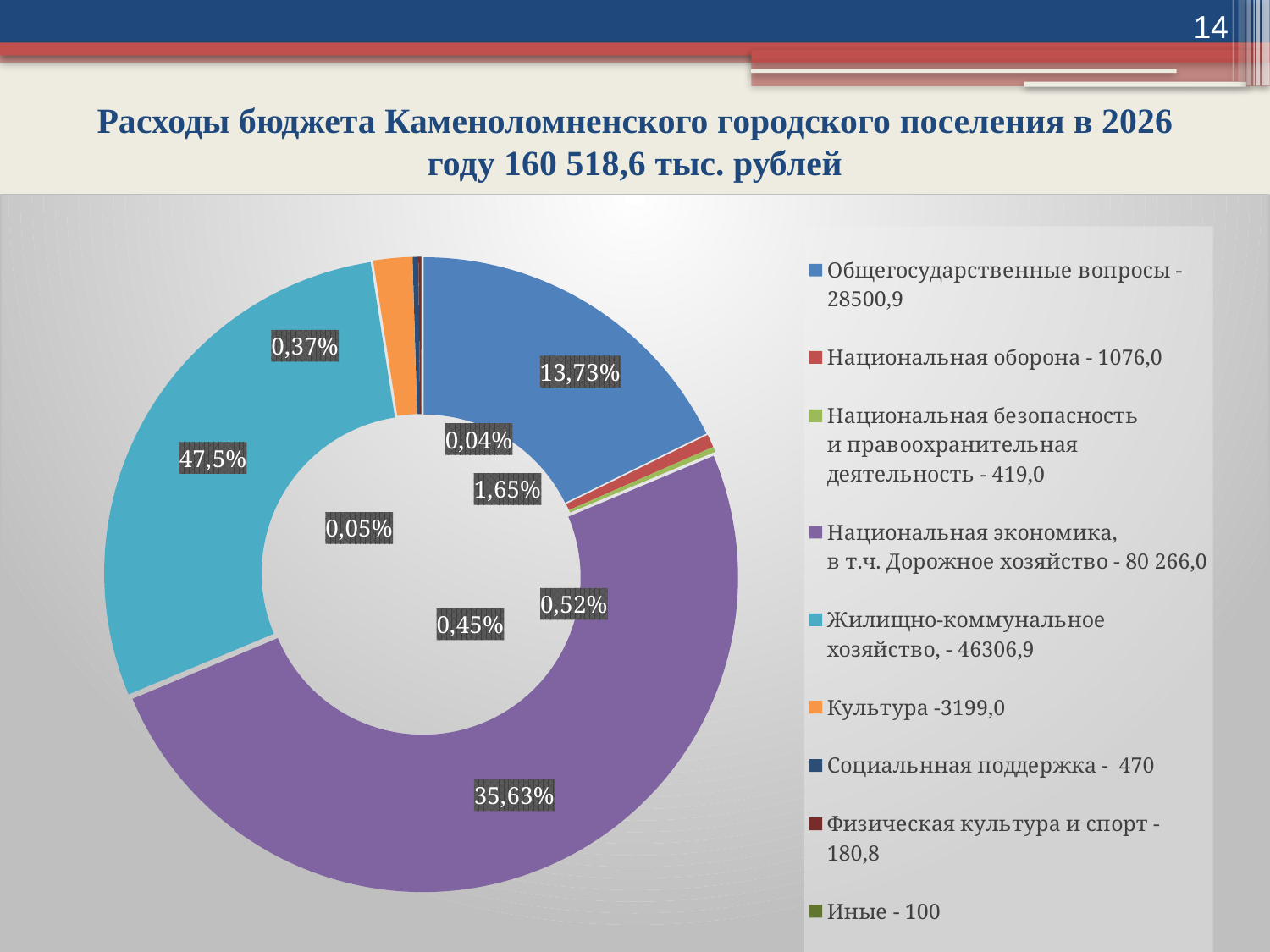
How many categories does the legend list? 9 According to the legend, what is the amount for Культура? 3199,0 What percentage label is shown on the teal slice (Жилищно-коммунальное хозяйство)? 47,5% Which is larger according to the legend: Культура or Социальная поддержка? Культура According to the legend, what is the amount for Национальная оборона? 1076,0 What percentage label is shown on the purple slice (Национальная экономика)? 35,63% What kind of chart is shown on the slide? Doughnut (pie) chart Which category has the smallest amount according to the legend? Иные - 100 What percentage label is shown on the blue slice (Общегосударственные вопросы)? 13,73% What is the difference between the legend amounts for Общегосударственные вопросы (28500,9) and Национальная оборона (1076,0)? 27424,9 Which category has the largest amount according to the legend? Национальная экономика, в т.ч. Дорожное хозяйство - 80 266,0 What total budget expenditure amount is stated in the chart title? 160 518,6 тыс. рублей